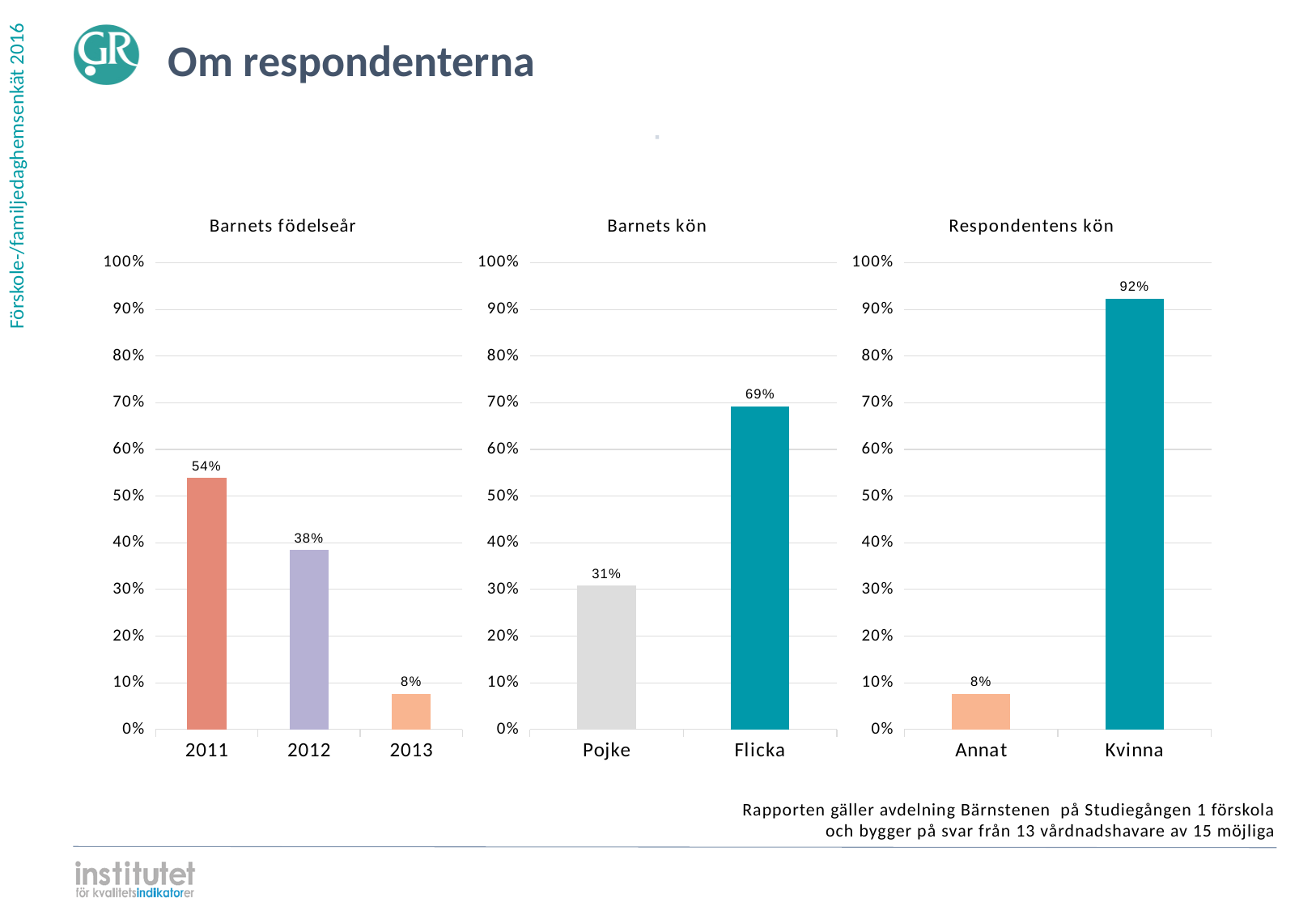
In the 'Barnets kön' chart, what is the value for Pojke? 31% In the 'Barnets födelseår' chart, do the values rise or fall from 2011 to 2013? fall In the 'Respondentens kön' chart, is the value for Annat greater or less than 10%? less In the 'Barnets födelseår' chart, which birth year has the lowest value? 2013 In the 'Respondentens kön' chart, what is the value for Kvinna? 92% In the 'Barnets födelseår' chart, what is the difference between the values for 2011 and 2012? 16% In the 'Barnets födelseår' chart, how many categories are shown? 3 In the 'Barnets kön' chart, which category has the highest value? Flicka In the 'Barnets kön' chart, what is the difference between Flicka and Pojke? 38% In the 'Respondentens kön' chart, which is larger, Annat or Kvinna? Kvinna What kind of chart is the 'Barnets kön' chart? bar chart In the 'Barnets födelseår' chart, what is the value for 2011? 54%